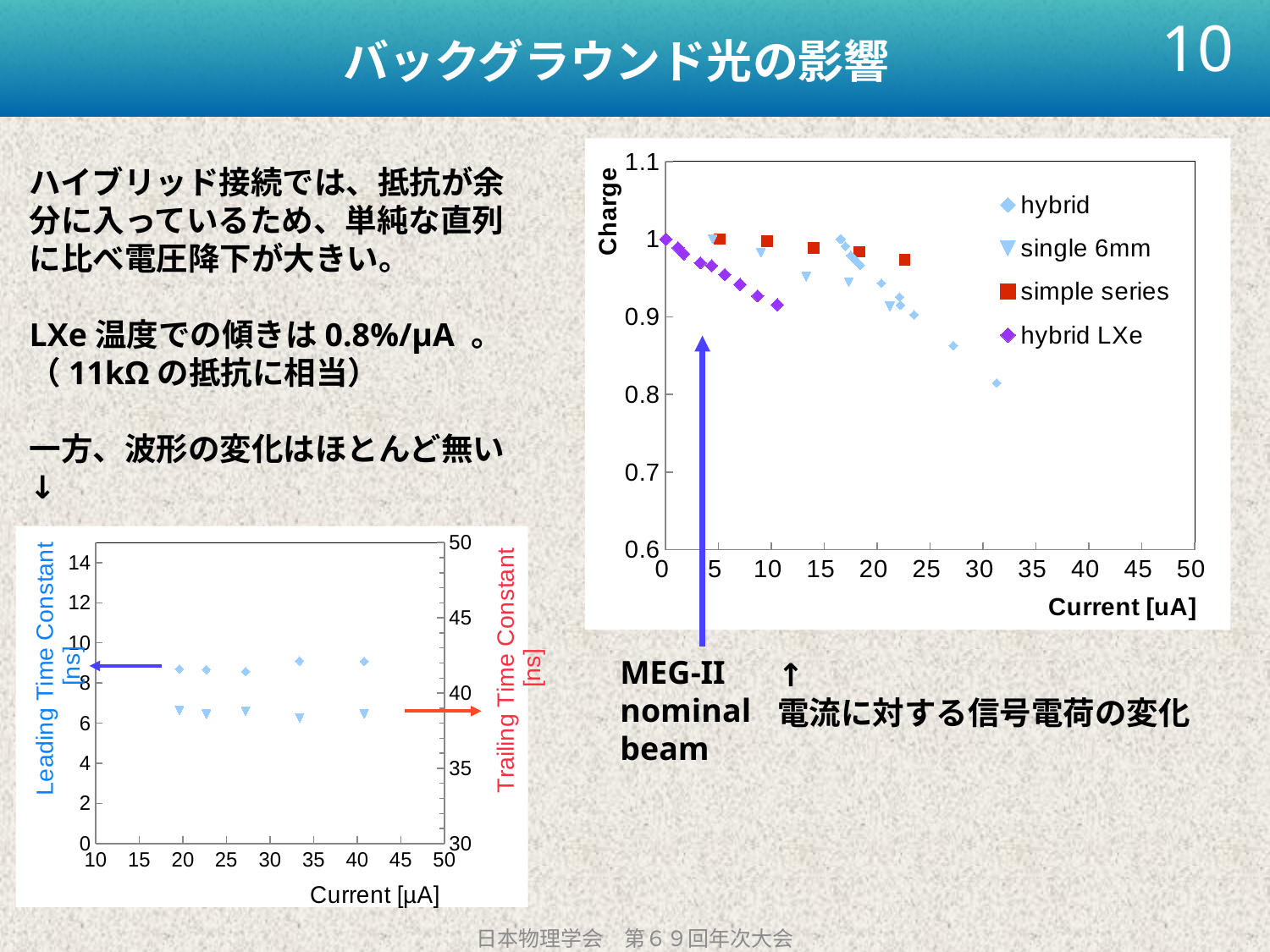
How many series does the legend of the right-hand chart (Charge vs Current) list? 4 In the bottom-left chart (time constants vs Current), are the Trailing Time Constant values greater or less than 45 ns? less In the right-hand chart (Charge vs Current), is the hybrid value at about 31 uA greater or less than 0.9? less What kind of chart is the chart on the right of the slide (Charge vs Current)? scatter chart In the right-hand chart (Charge vs Current), do the hybrid LXe values rise or fall as current increases? fall In the right-hand chart (Charge vs Current), is the hybrid value at about 27 uA greater or less than 0.9? less What kind of chart is the chart at the bottom left of the slide (time constants vs Current)? scatter chart In the bottom-left chart (time constants vs Current), how many Leading Time Constant points (diamonds) are plotted? 5 In the right-hand chart (Charge vs Current), what is the label of the x axis? Current [uA] In the right-hand chart (Charge vs Current), which series is shown with purple diamond markers? hybrid LXe